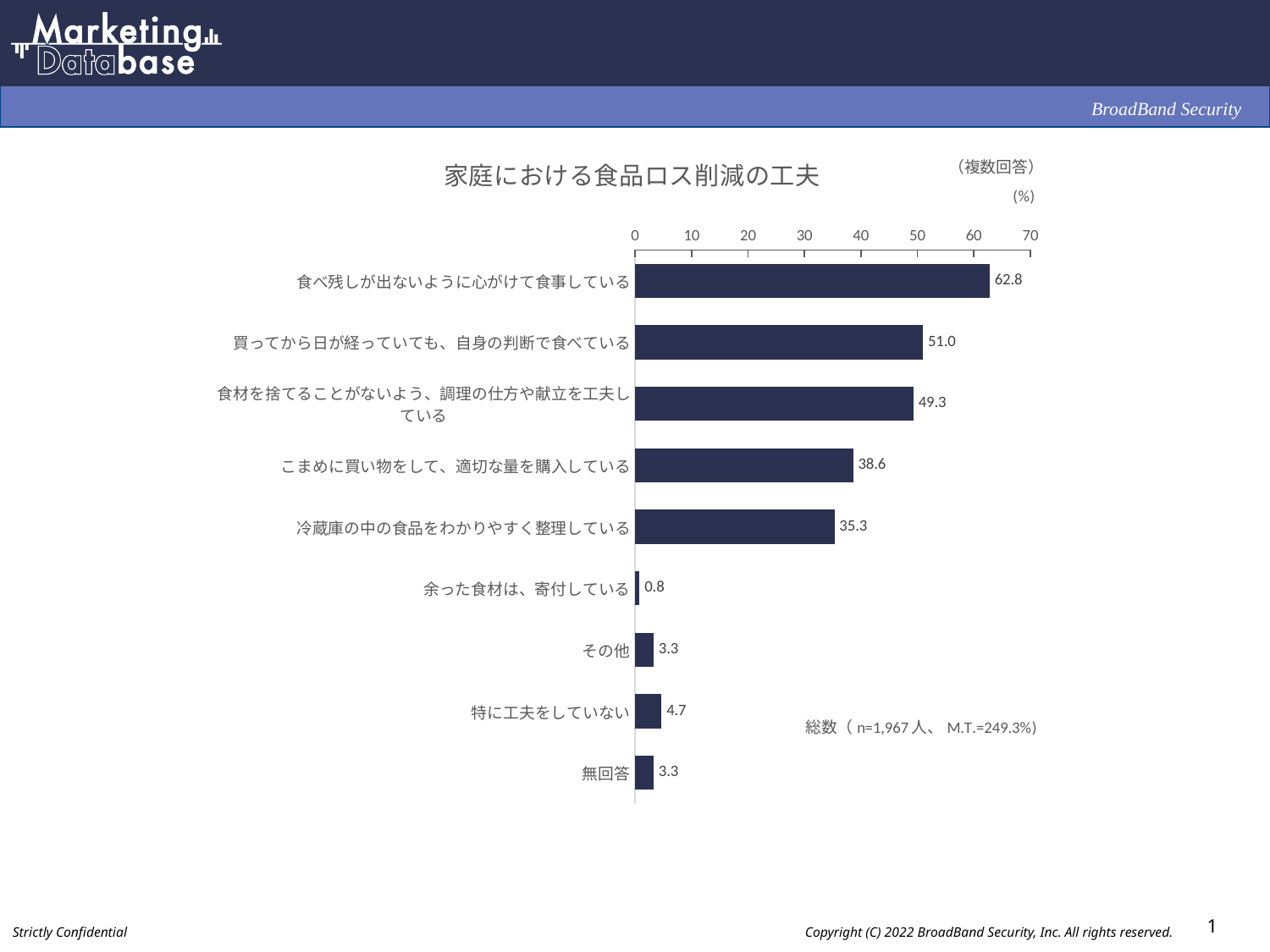
What is the value for 特に工夫をしていない? 4.7 Which category has the highest value? 食べ残しが出ないように心がけて食事している What is the sample size (n) shown on the slide? n=1,967 What is the value for 冷蔵庫の中の食品をわかりやすく整理している? 35.3 What is the title of the chart? 家庭における食品ロス削減の工夫 What is the value for 食べ残しが出ないように心がけて食事している? 62.8 How many categories are shown in the chart? 9 What is the difference between the values for 買ってから日が経っていても、自身の判断で食べている and 食材を捨てることがないよう、調理の仕方や献立を工夫している? 1.7 Which is larger: the value for こまめに買い物をして、適切な量を購入している or the value for 冷蔵庫の中の食品をわかりやすく整理している? こまめに買い物をして、適切な量を購入している Is the value for 買ってから日が経っていても、自身の判断で食べている greater or less than 50? greater What kind of chart is shown on the slide? bar chart Which category has the lowest value? 余った食材は、寄付している